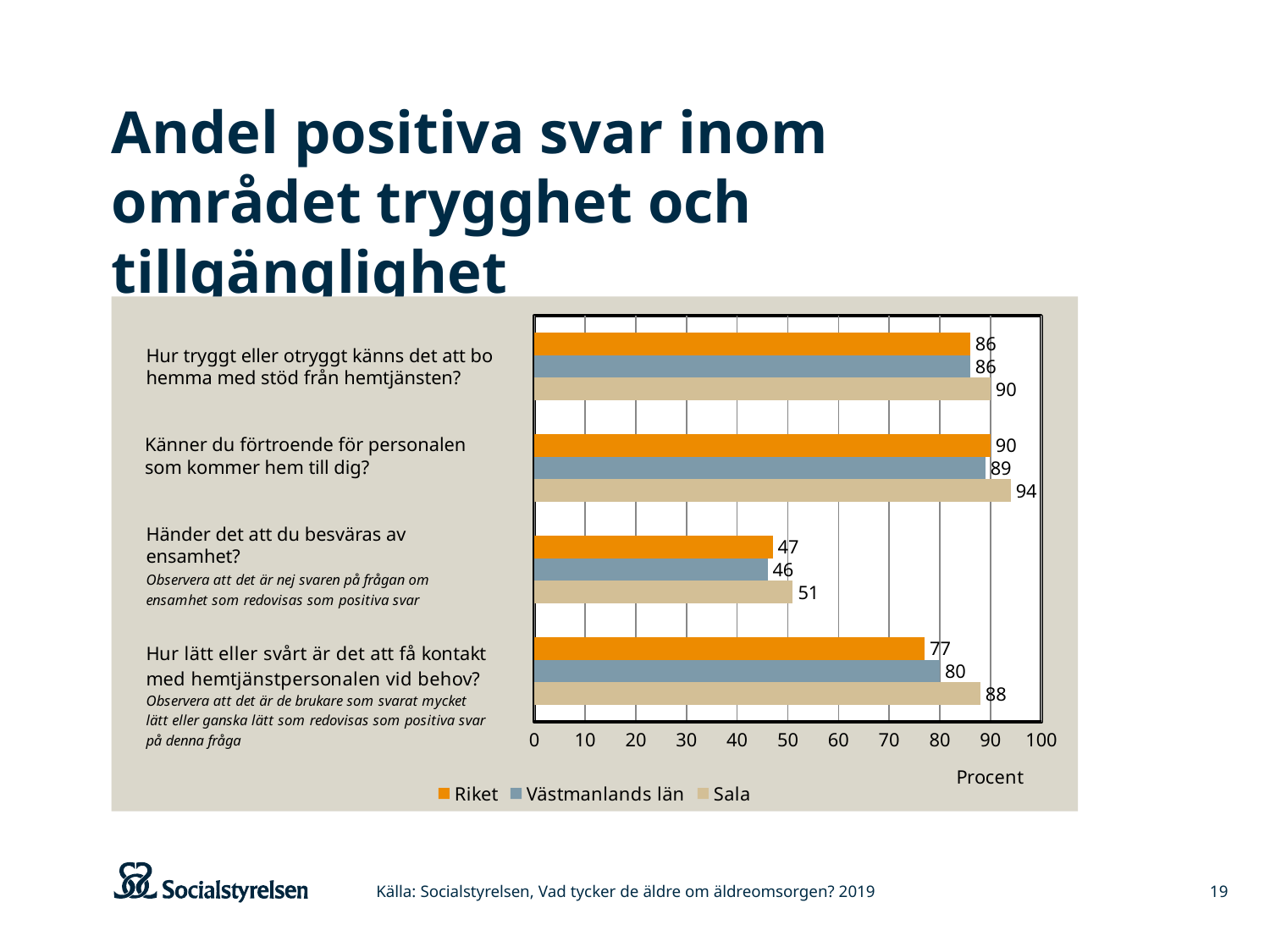
What type of chart is shown on the slide? bar chart What label is shown on the horizontal axis? Procent What is the value for Sala on the question 'Hur tryggt eller otryggt känns det att bo hemma med stöd från hemtjänsten?' 90 What is the value for Riket on the question 'Händer det att du besväras av ensamhet?' 47 Which question has the highest value for Riket? Känner du förtroende för personalen som kommer hem till dig? What is the difference between Sala and Riket on the question 'Hur lätt eller svårt är det att få kontakt med hemtjänstpersonalen vid behov?' 11 What is the value for Västmanlands län on the question 'Hur lätt eller svårt är det att få kontakt med hemtjänstpersonalen vid behov?' 80 Which question has the lowest value for Sala? Händer det att du besväras av ensamhet? How many series does the legend list? 3 How many questions (categories) are shown on the chart? 4 Which is larger on the question 'Händer det att du besväras av ensamhet?': Riket or Sala? Sala What is the value for Sala on the question 'Känner du förtroende för personalen som kommer hem till dig?' 94